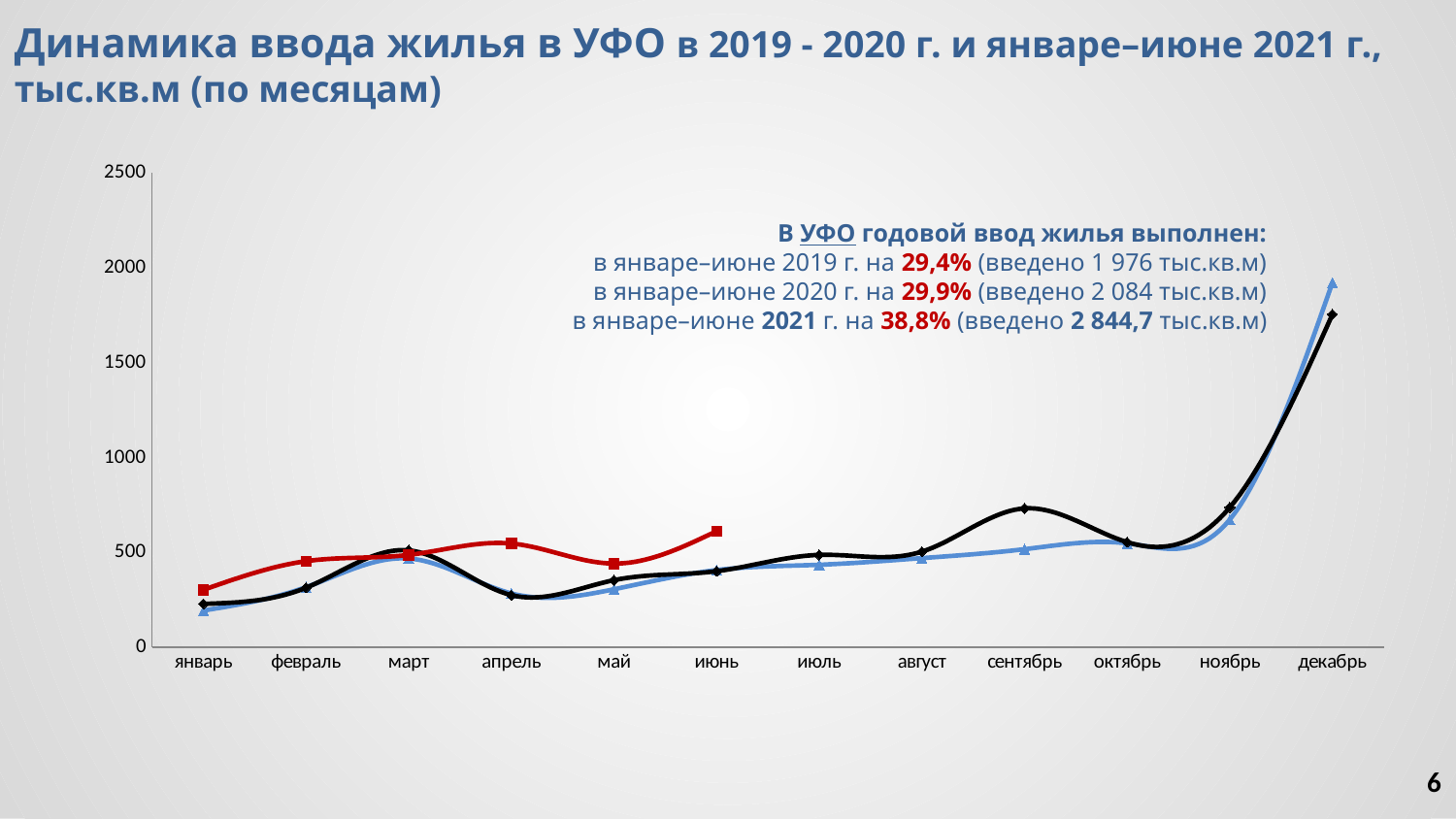
In which month does the blue line reach its highest value? декабрь Is the value of the blue line in апрель greater or less than 500? less How many months are shown along the x axis of the chart? 12 Is the value of the blue line in декабрь greater or less than 1500? greater What kind of chart is shown on the slide? line chart In which month does the red line end? июнь In сентябрь, which line has the higher value, the black line or the blue line? black line In which month does the blue line have its lowest value? январь Is the value of the red line in январь greater or less than 500? less How many lines are plotted on the chart? 3